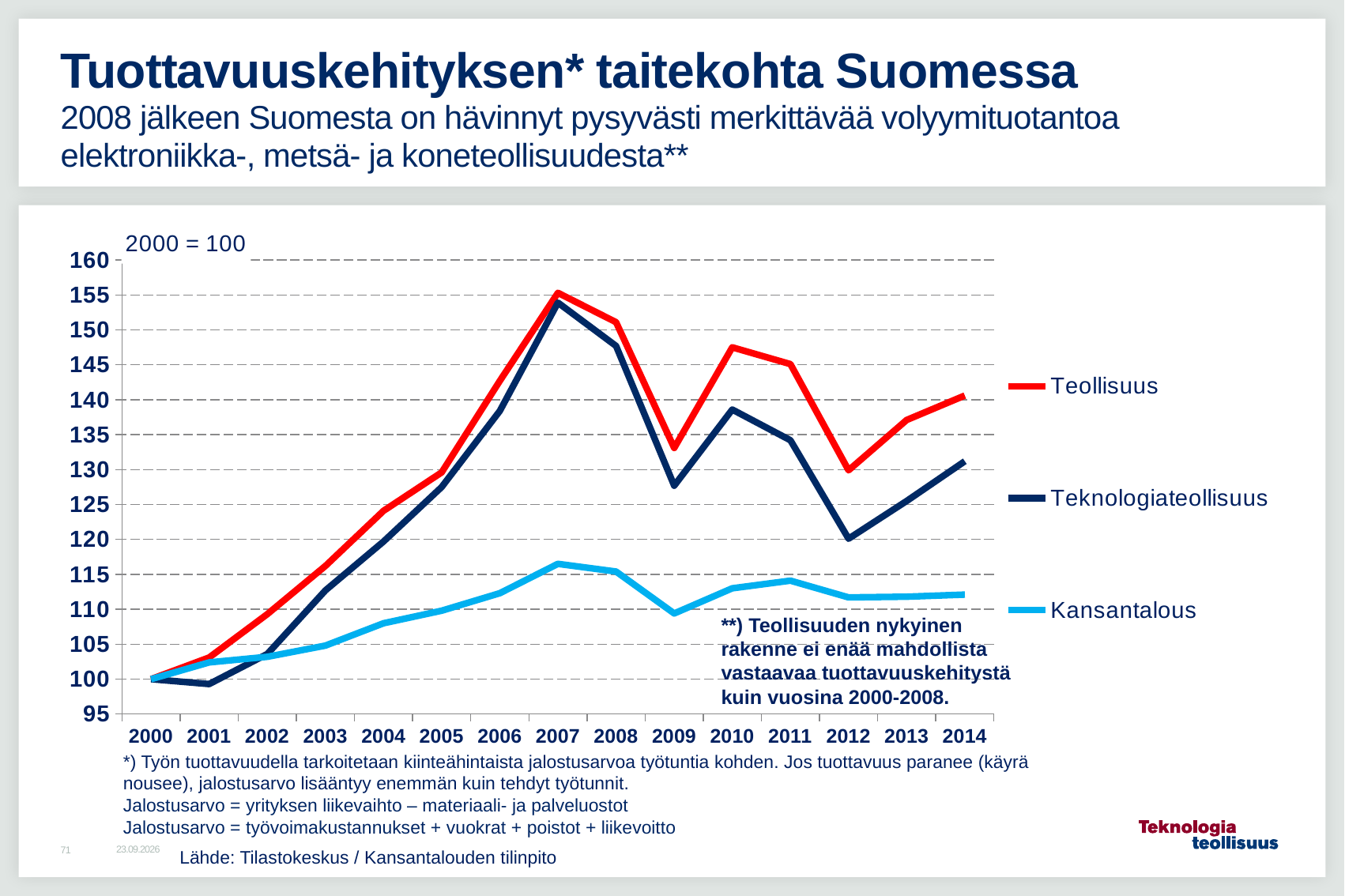
Which series has the higher value in 2010, Teollisuus or Teknologiateollisuus? Teollisuus In which year is the Teollisuus series at its lowest value? 2000 What is the index value of the series in the base year 2000? 100 Does the Teknologiateollisuus series rise or fall from 2012 to 2014? rise Is the value for Teollisuus in 2012 greater or less than 135? less Is the value for Teknologiateollisuus in 2010 greater or less than 135? greater What type of chart is shown on the slide? line chart Is the value for Kansantalous in 2014 greater or less than 115? less In which year does the Teollisuus series reach its highest value? 2007 How many series does the legend list? 3 In which year does the Teknologiateollisuus series reach its highest value? 2007 How many years are plotted along the x axis? 15